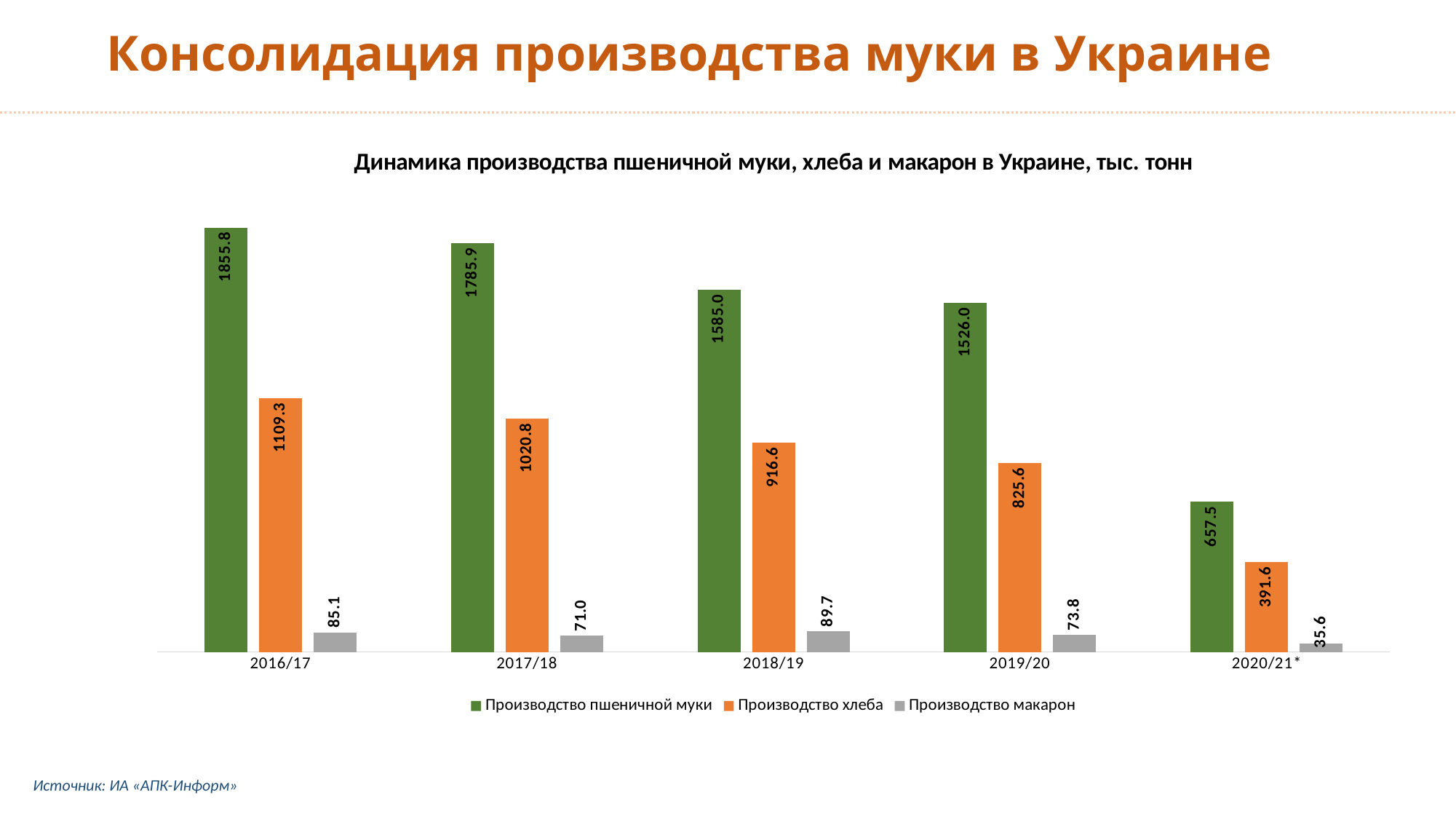
In which season is Производство пшеничной муки lowest? 2020/21* Does Производство хлеба rise or fall from 2016/17 to 2020/21*? Fall How many seasons are shown on the x axis? 5 In which season is Производство макарон highest? 2018/19 What kind of chart is shown on the slide? Bar chart Which is larger: Производство макарон in 2017/18 or in 2019/20? 2019/20 What is the difference between Производство пшеничной муки in 2016/17 and 2017/18? 69.9 What is the value for Производство макарон in 2020/21*? 35.6 What is the value for Производство пшеничной муки in 2016/17? 1855.8 What is the value for Производство хлеба in 2018/19? 916.6 How many series does the legend list? 3 What is the difference between Производство хлеба in 2016/17 and 2020/21*? 717.7